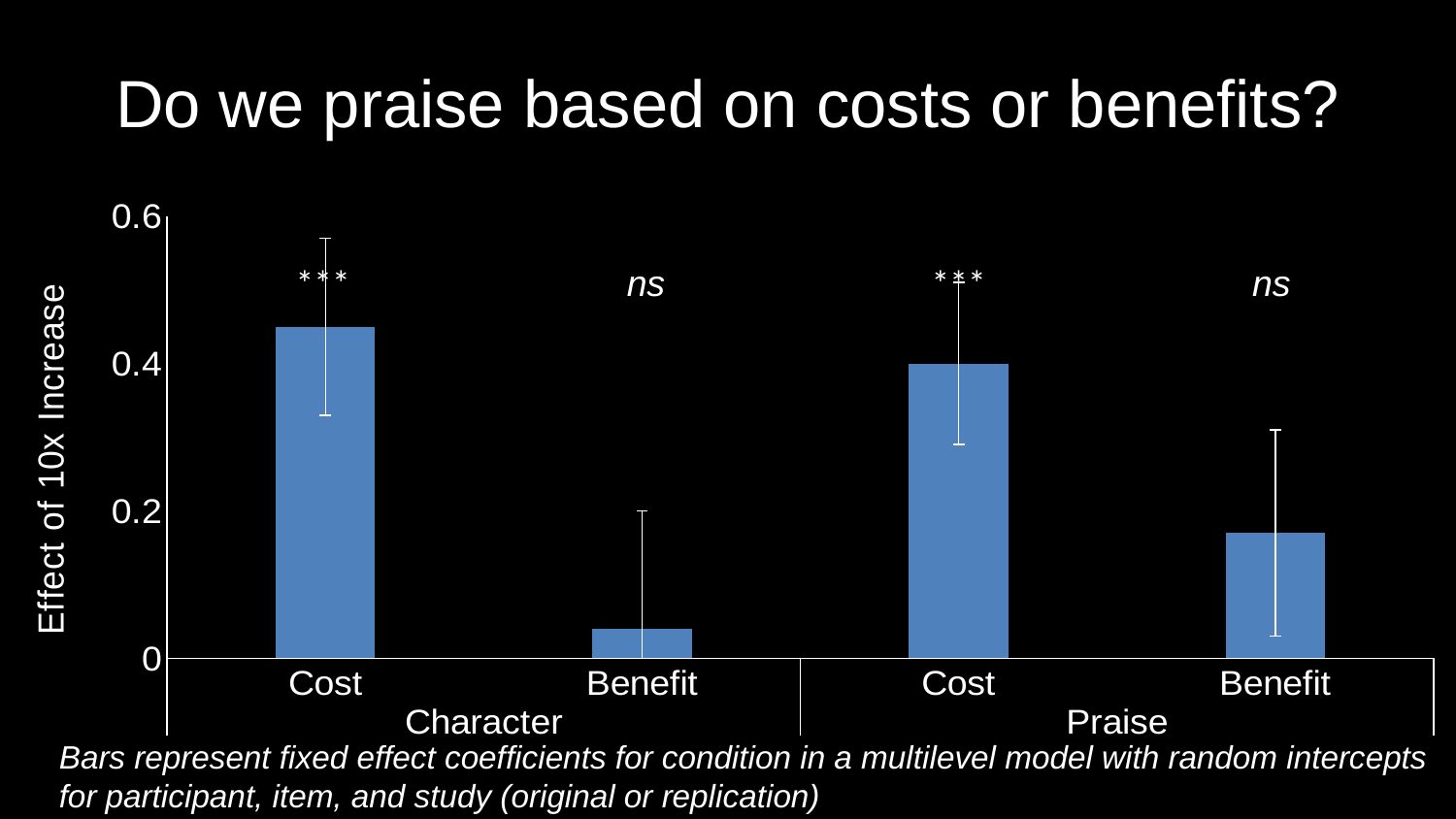
Is the value for Benefit under Character greater or less than 0.2? less Which bars are marked as not significant (ns) in the chart? The Benefit bars (Character and Praise) How many bars are plotted in the chart? 4 Is the value for Cost under Character greater or less than 0.4? greater What kind of chart is shown on the slide? Bar chart Which bar has the highest value in the chart? Cost (Character) What is the label on the y-axis of the chart? Effect of 10x Increase Which is larger: the Benefit bar under Character or the Benefit bar under Praise? Benefit (Praise) How many condition groups (x-axis group labels) does the chart show? 2 Which bar has the lowest value in the chart? Benefit (Character) Which is larger: the Cost bar under Character or the Cost bar under Praise? Cost (Character) Is the value for Benefit under Praise greater or less than 0.2? less